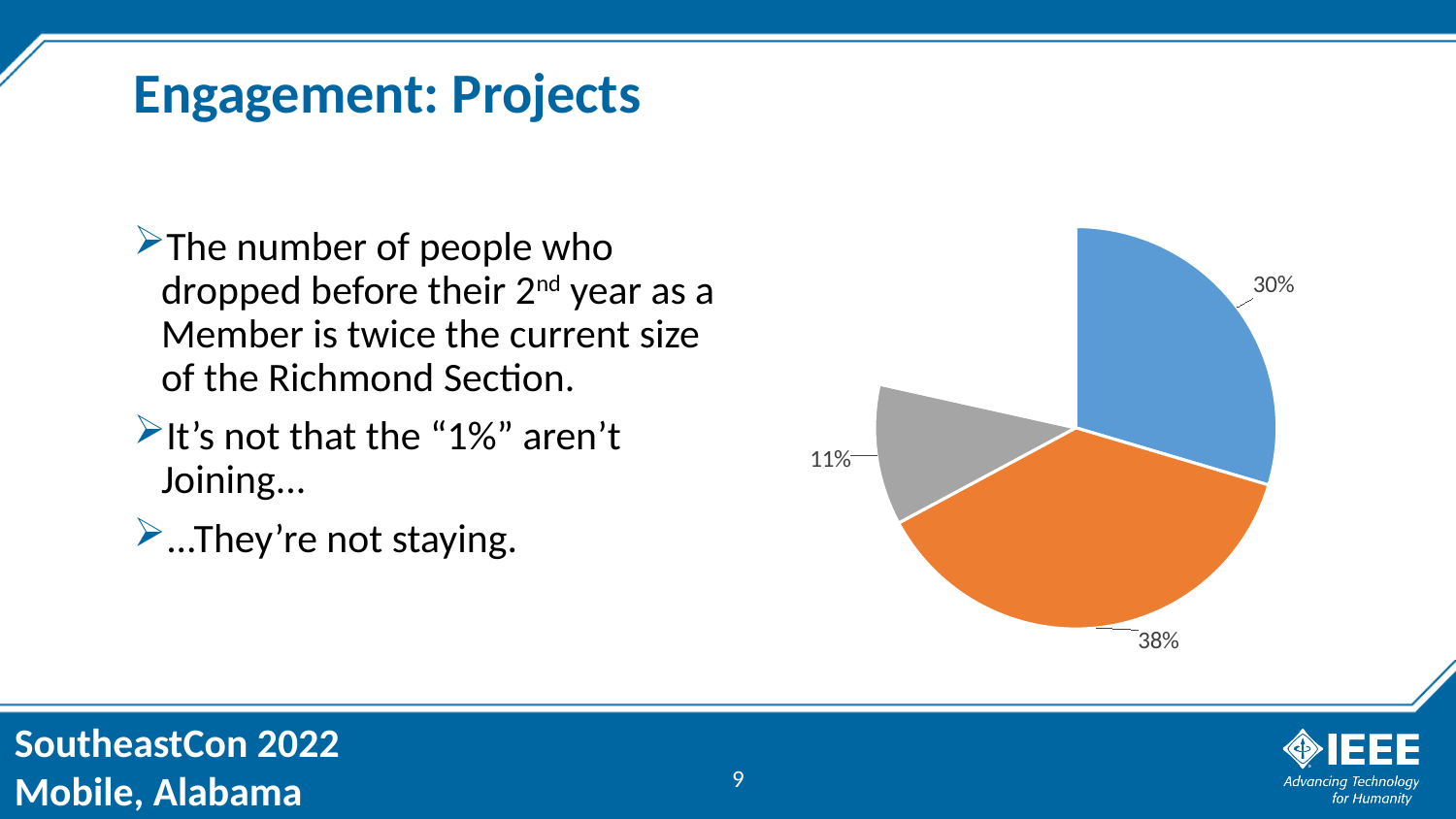
What is the difference between the blue slice's percentage and the gray slice's percentage? 19 percentage points Which slice of the pie chart is the largest? the orange slice (38%) Which is larger, the blue slice or the gray slice? the blue slice What percentage is shown for the orange slice of the pie chart? 38% Does the pie chart include a legend? No What is the difference between the orange slice's percentage and the blue slice's percentage? 8 percentage points What percentage is shown for the gray slice of the pie chart? 11% Is the value of the orange slice greater or less than 35%? greater What percentage is shown for the blue slice of the pie chart? 30% What kind of chart is shown on the slide? pie chart